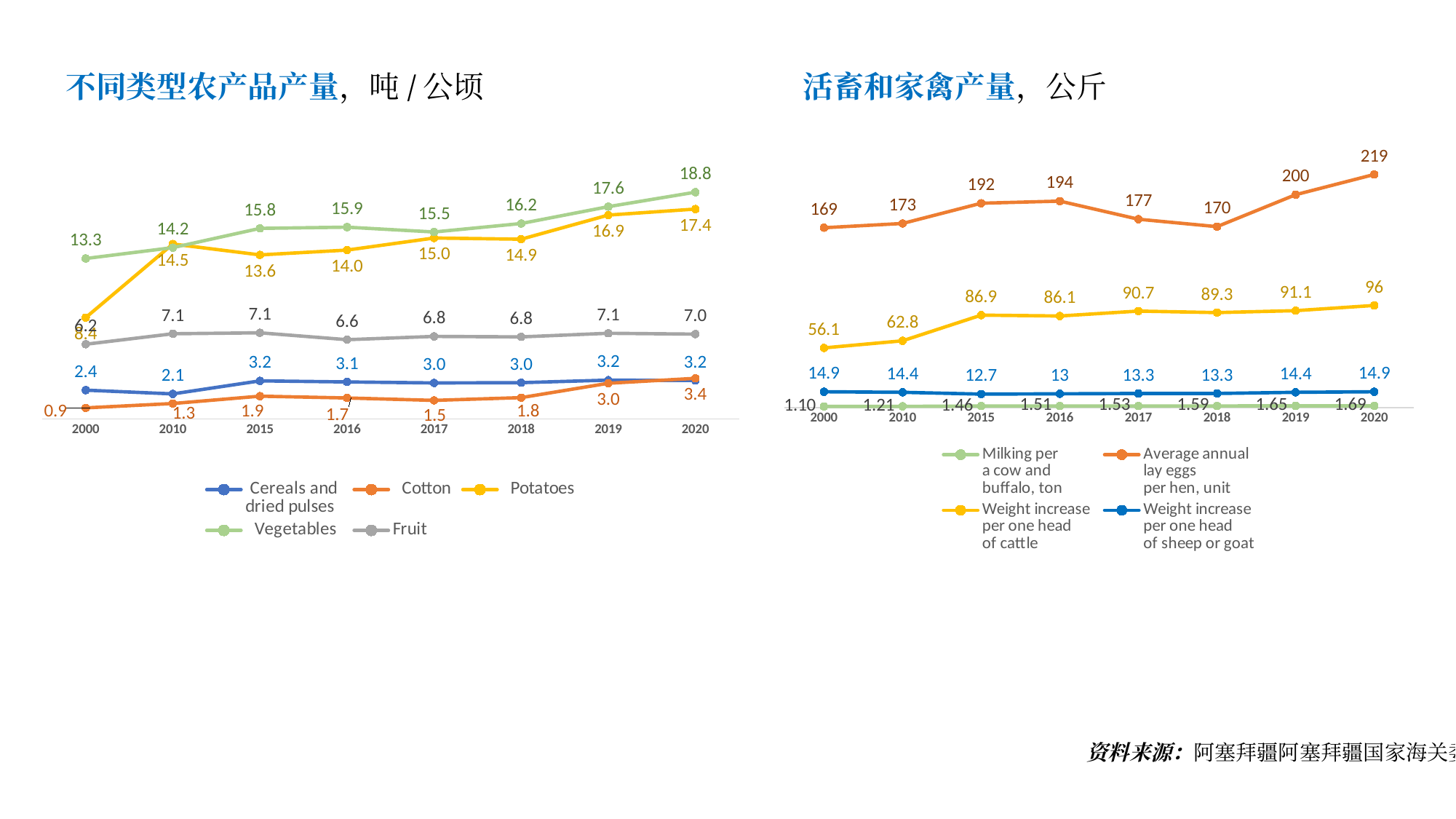
In the left chart (不同类型农产品产量), how many series does the legend list? 5 In the right chart (活畜和家禽产量), does the Milking per a cow and buffalo series rise or fall from 2000 to 2020? Rise In the right chart (活畜和家禽产量), what is the value for Average annual lay eggs per hen in 2020? 219 In the right chart (活畜和家禽产量), what is the difference between the Average annual lay eggs per hen values in 2020 and 2000? 50 In the left chart (不同类型农产品产量), in which year is the Vegetables value highest? 2020 In the right chart (活畜和家禽产量), in which year is the Weight increase per one head of cattle lowest? 2000 In the left chart (不同类型农产品产量), which is larger in 2019: Cereals and dried pulses or Cotton? Cereals and dried pulses In the right chart (活畜和家禽产量), how many years are shown on the x axis? 8 In the left chart (不同类型农产品产量), what is the value for Cotton in 2000? 0.9 What kind of chart is the left chart (不同类型农产品产量)? Line chart In the left chart (不同类型农产品产量), what is the difference between the Vegetables and Potatoes values in 2020? 1.4 In the left chart (不同类型农产品产量), what is the value for Vegetables in 2020? 18.8